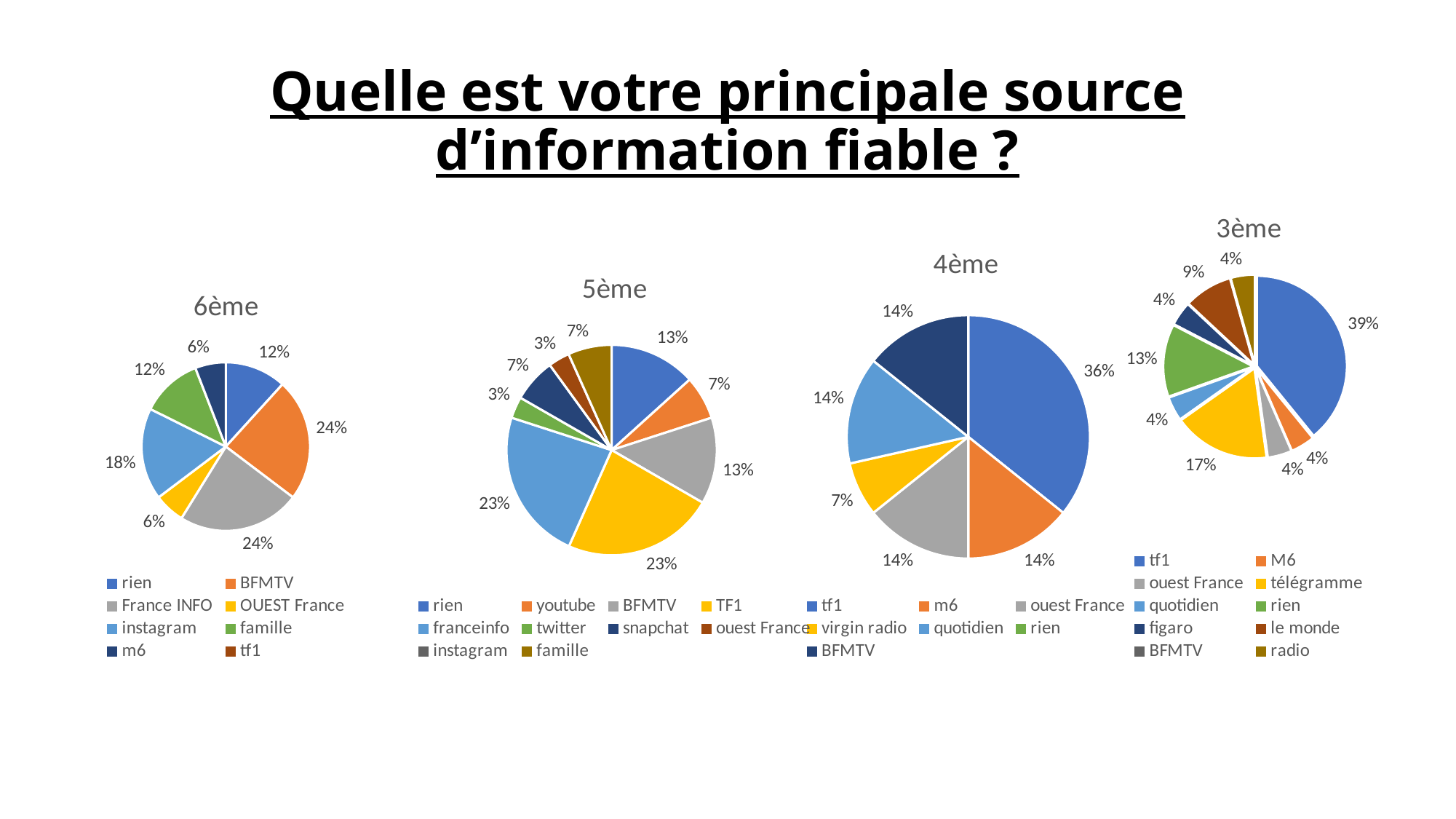
In the 6ème chart, what share does instagram have? 18% What type of charts are shown on the slide? Pie charts In the 5ème chart, which is larger, the share for franceinfo or the share for BFMTV? franceinfo In the 4ème chart, which source has the largest share? tf1 In the 3ème chart, what is the difference between the shares of tf1 and rien? 26% In the 3ème chart, what share does télégramme have? 17% How many entries does the legend of the 3ème chart list? 10 In the 5ème chart, what share does TF1 have? 23% In the 5ème chart, what share does youtube have? 7% In the 3ème chart, what share does tf1 have? 39% In the 6ème chart, what share does BFMTV have? 24% In the 4ème chart, what share does virgin radio have? 7%